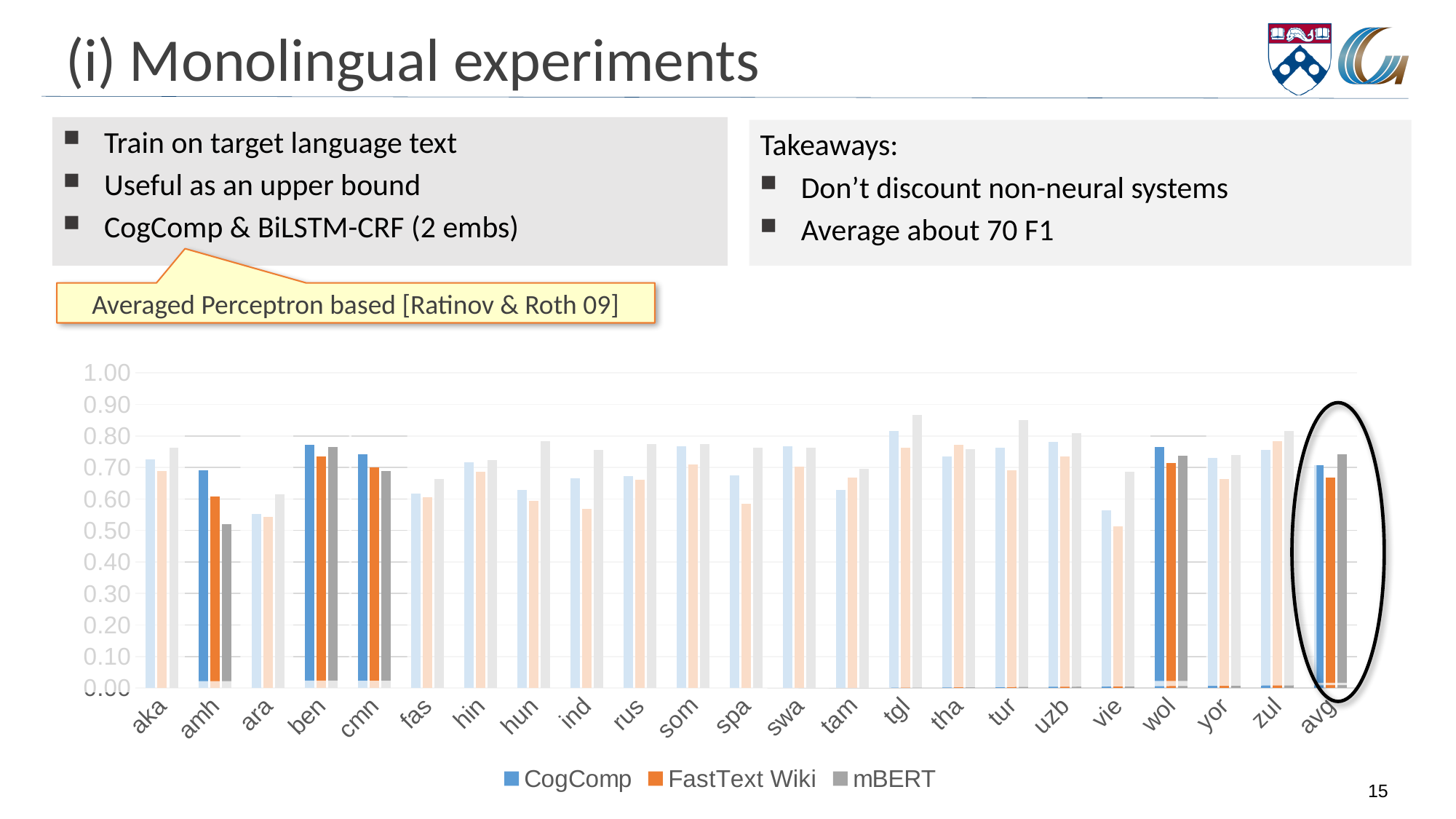
How many series does the chart's legend list? 3 What kind of chart is shown on the slide? bar chart Is the mBERT value for amh greater or less than 0.60? less Is the CogComp value for ben greater or less than 0.70? greater Is the mBERT value for tgl greater or less than 0.80? greater How many categories are shown along the x axis of the chart? 23 Which category has the lowest mBERT value? amh Which series are listed in the chart's legend? CogComp, FastText Wiki, mBERT For amh, which is larger: the CogComp value or the mBERT value? CogComp Which category on the x axis is circled on the chart? avg